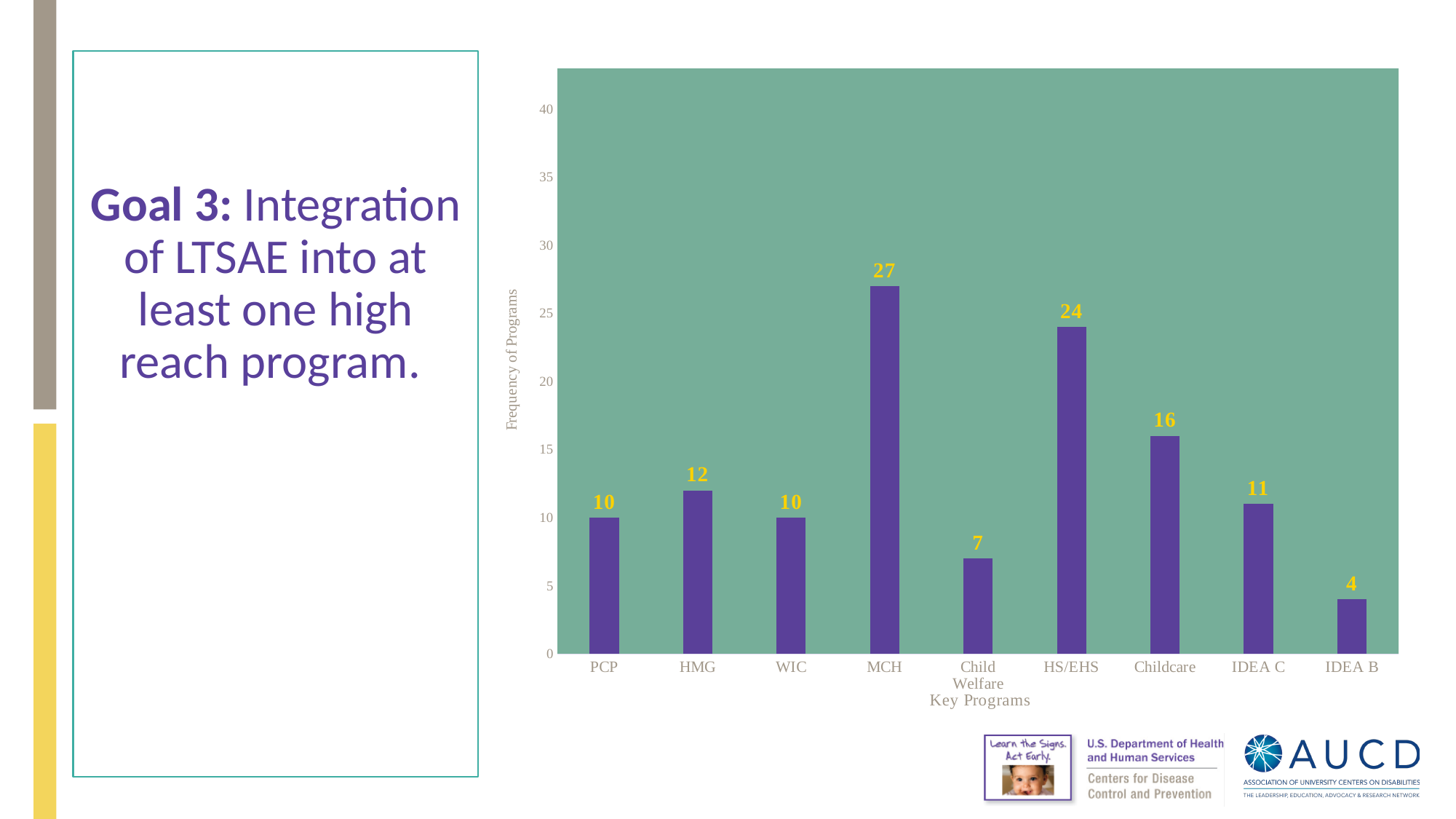
Which key program has the lowest frequency of programs? IDEA B What kind of chart is shown on the slide? bar chart How many key programs are shown on the x axis? 9 What is the label of the y axis? Frequency of Programs What is the value for HS/EHS? 24 Is the value for Childcare greater or less than 15? greater What is the difference between the values for Childcare and IDEA B? 12 Which is larger, the value for HMG or the value for IDEA C? HMG What is the difference between the values for MCH and HS/EHS? 3 Which key program has the highest frequency of programs? MCH What is the value for MCH? 27 What is the value for Child Welfare? 7